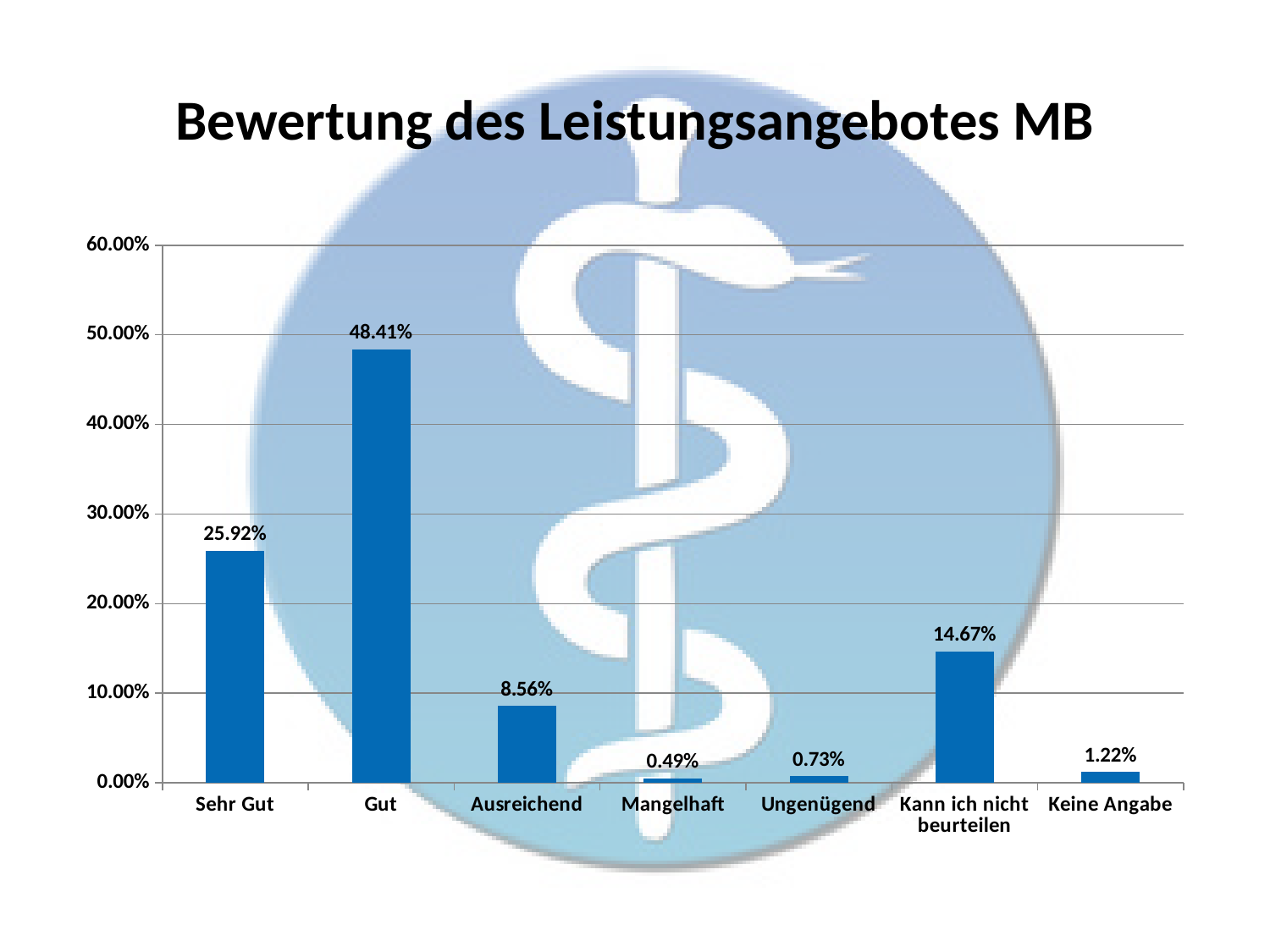
What is the difference between the values for Keine Angabe and Ungenügend? 0.49% What is the value for Mangelhaft? 0.49% What is the title of the chart? Bewertung des Leistungsangebotes MB Which category has the highest value? Gut What is the value for Kann ich nicht beurteilen? 14.67% What kind of chart is shown on the slide? bar chart How many categories are shown on the x axis? 7 What is the difference between the values for Gut and Sehr Gut? 22.49% Which category has the lowest value? Mangelhaft Which is larger, the value for Ausreichend or the value for Kann ich nicht beurteilen? Kann ich nicht beurteilen Is the value for Sehr Gut greater or less than 20.00%? greater What is the value for Gut? 48.41%